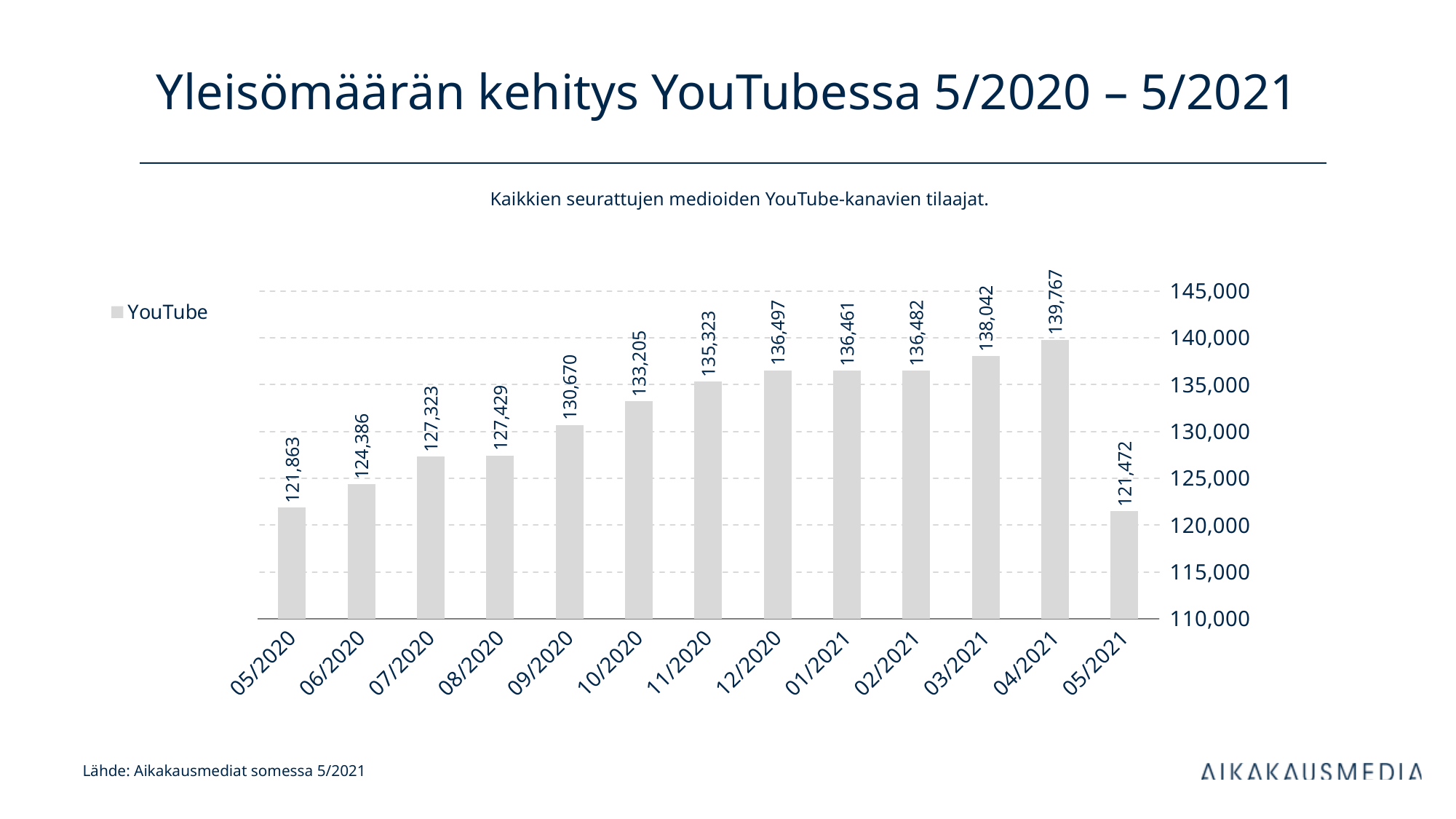
What is the difference between the values for 04/2021 and 05/2021? 18,295 What is the difference between the values for 06/2020 and 05/2020? 2,523 What is the value for 05/2021? 121,472 What kind of chart is shown on the slide? bar chart What is the value for 09/2020? 130,670 Which is larger, the value for 03/2021 or the value for 10/2020? 03/2021 Is the value for 11/2020 greater or less than 130,000? greater How many months are shown on the x axis? 13 What is the value for 12/2020? 136,497 What series name does the legend show? YouTube Which month has the highest value? 04/2021 Which month has the lowest value? 05/2021